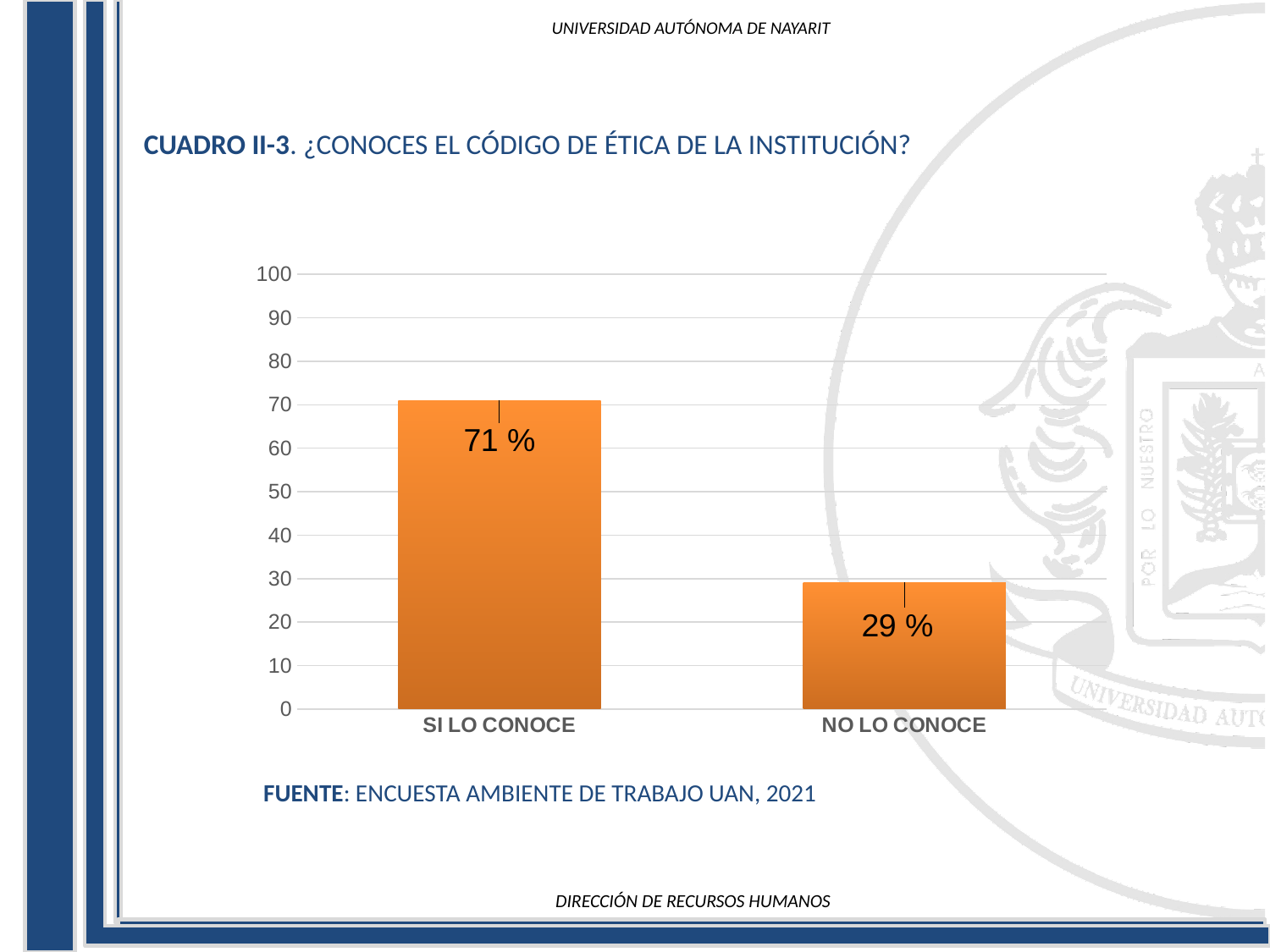
What is the total of the two values shown in the chart? 100 % What kind of chart is shown on the slide? Bar chart Which is larger, the value for SI LO CONOCE or the value for NO LO CONOCE? SI LO CONOCE What is the source cited below the chart? ENCUESTA AMBIENTE DE TRABAJO UAN, 2021 What is the value for NO LO CONOCE? 29 % Which category has the lowest value? NO LO CONOCE What is the difference between the values for SI LO CONOCE and NO LO CONOCE? 42 % Is the value for NO LO CONOCE greater or less than 40? less How many categories are shown on the x axis? 2 Which category has the highest value? SI LO CONOCE Is the value for SI LO CONOCE greater or less than 60? greater What is the value for SI LO CONOCE? 71 %